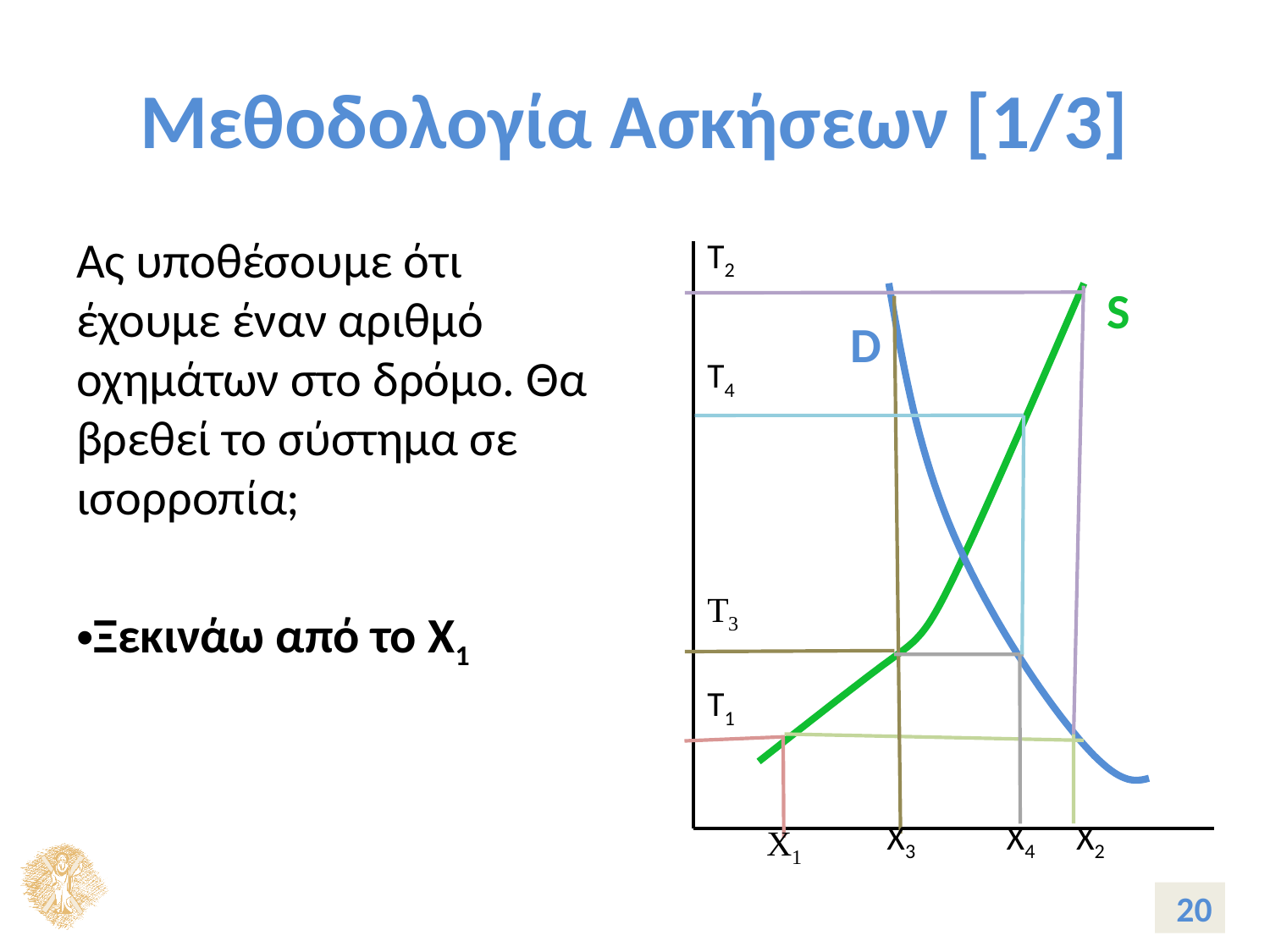
How many labelled positions are marked on the x axis? 4 What kind of chart is shown on the slide? line chart At X2, which curve is higher, S or D? S Does the curve labelled D rise or fall as you move to the right along the x axis? falls Which labelled x-axis position is furthest to the left? X1 How many curves are plotted in the chart? 2 Does the curve labelled S rise or fall as you move to the right along the x axis? rises At X3, which curve is higher, S or D? D Which labelled x-axis position is furthest to the right? X2 What are the labels of the two curves in the chart? S and D What colour is the curve labelled S? green Which labelled level on the vertical axis is the highest? T2